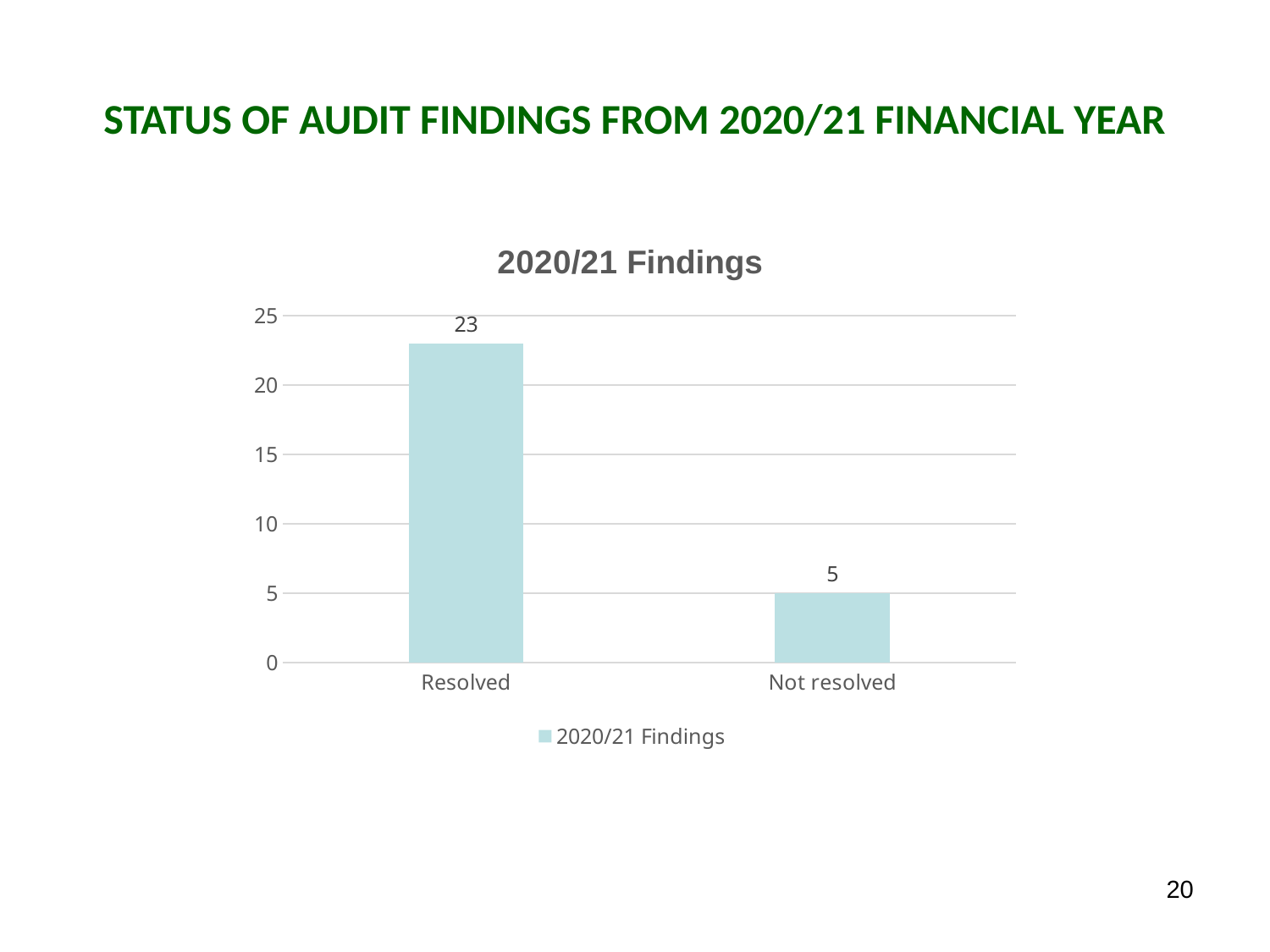
Is the value for Not resolved greater or less than 10? less What is the title of the chart? 2020/21 Findings What is the difference between the Resolved and Not resolved values? 18 What is the value for Not resolved? 5 What is the value for Resolved? 23 How many series does the legend list? 1 Is the value for Resolved greater or less than 20? greater Which category has the highest value? Resolved Which category has the lowest value? Not resolved What kind of chart is shown? bar chart Which is larger, Resolved or Not resolved? Resolved How many categories are shown on the x axis? 2